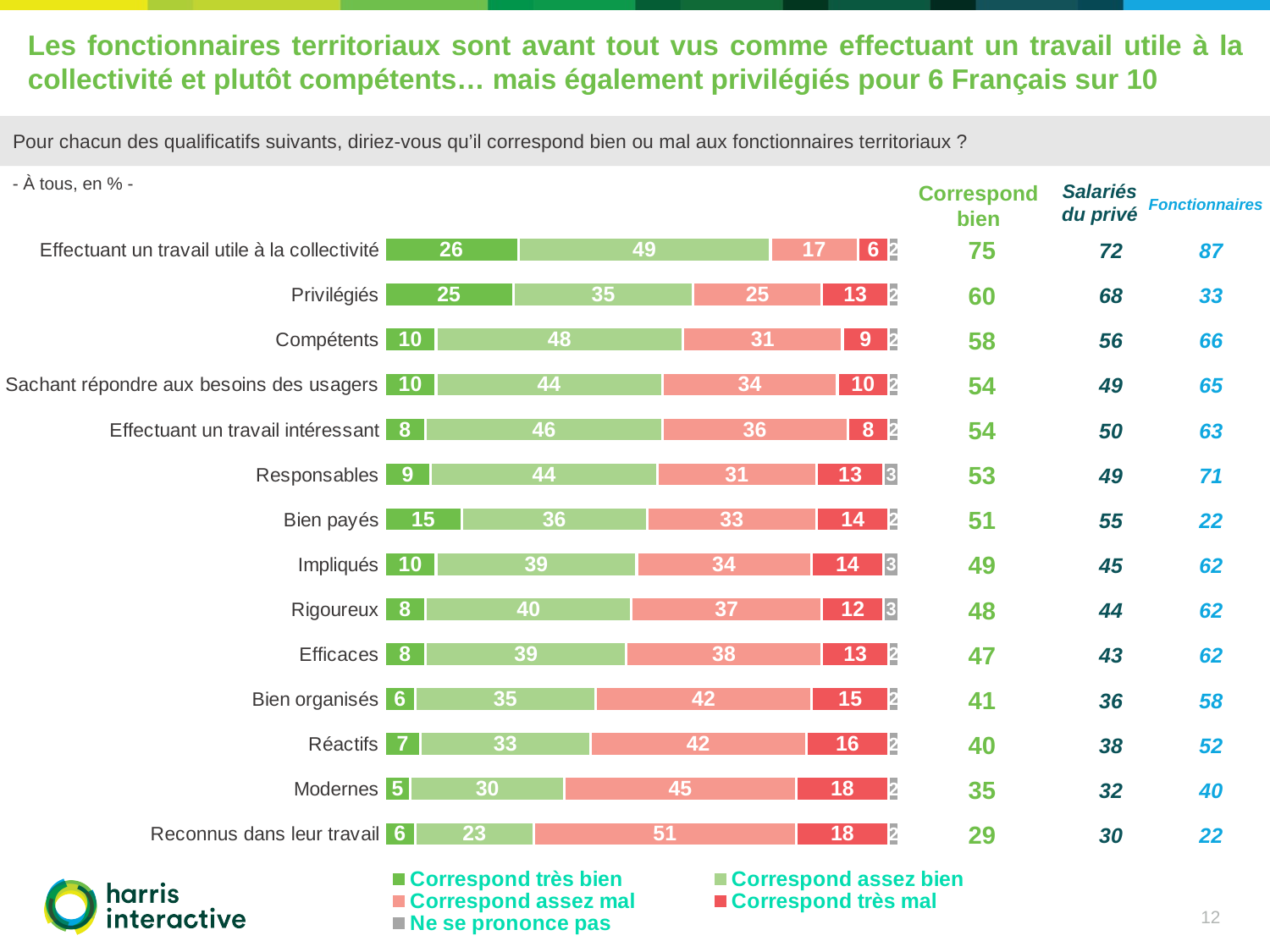
Which category has the highest "Correspond assez bien" value? Effectuant un travail utile à la collectivité What is the combined total of "Correspond très bien" and "Correspond assez bien" for "Responsables"? 53 Which category has the lowest "Correspond très bien" value? Modernes Which has a larger "Correspond très bien" value: "Bien payés" or "Impliqués"? Bien payés What is the "Correspond assez mal" value for "Reconnus dans leur travail"? 51 How many qualificatifs (categories) are shown in the chart? 14 What type of chart is shown on the slide? Stacked bar chart Which category has the highest "Correspond très bien" value? Effectuant un travail utile à la collectivité What colour represents "Ne se prononce pas" in the legend? Grey What percentage of respondents say "Correspond très bien" for "Privilégiés"? 25 For "Compétents", what is the difference between the "Correspond assez bien" value and the "Correspond très bien" value? 38 How many series does the legend list? 5